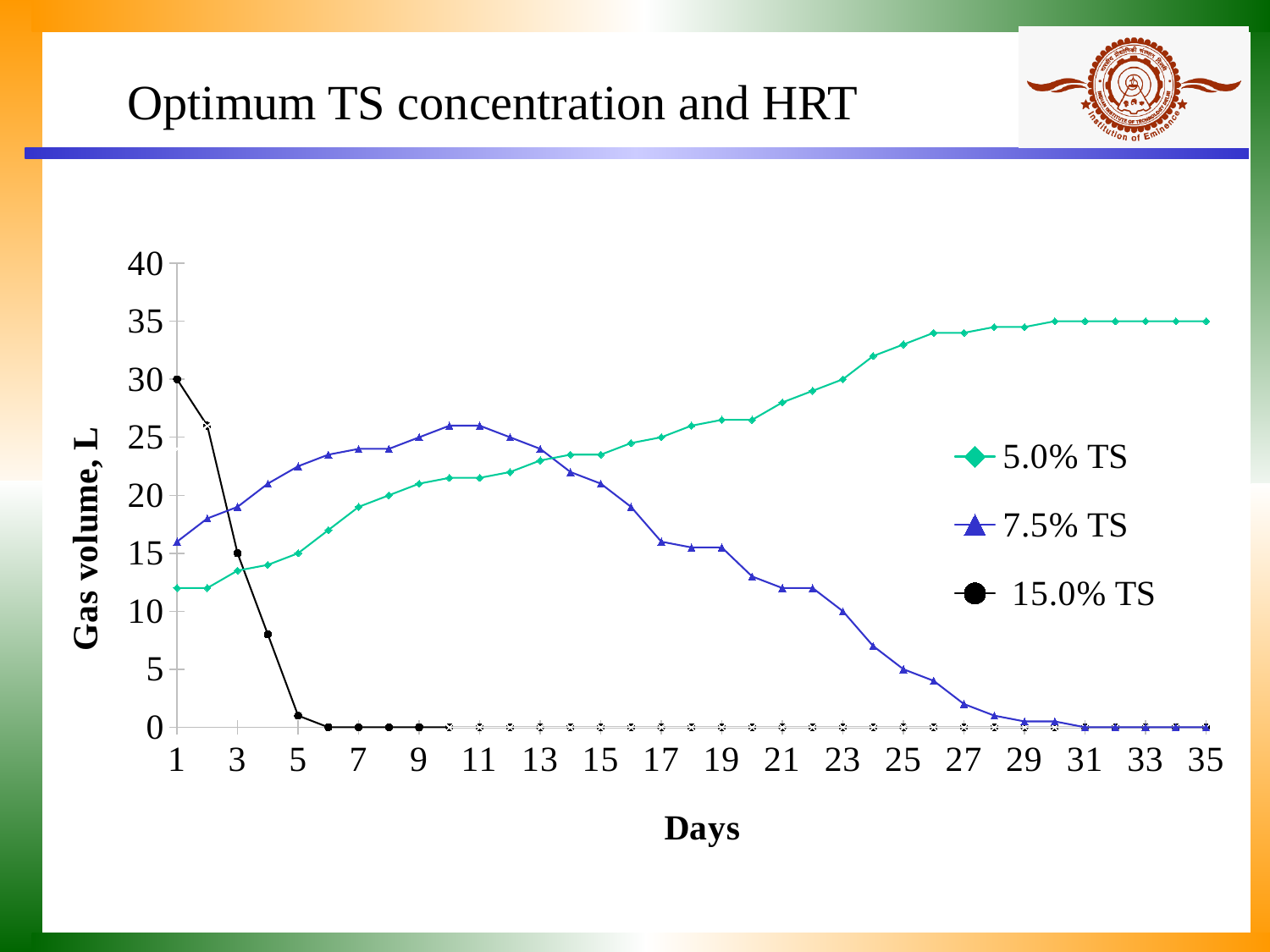
Is the value for 15.0% TS on day 4 greater or less than 10? less What is the gas volume for 15.0% TS on day 1? 30 What is the title of the x axis? Days What is the gas volume for 5.0% TS on day 35? 35 Does the gas volume for 5.0% TS rise or fall from day 1 to day 35? Rise Which series has the highest gas volume on day 1? 15.0% TS How many series does the legend list? 3 What kind of chart is shown on the slide? Line chart Is the value for 5.0% TS on day 25 greater or less than 30? greater Which series reaches the highest gas volume anywhere on the chart? 5.0% TS What is the gas volume for 15.0% TS on day 10? 0 What is the title of the y axis? Gas volume, L